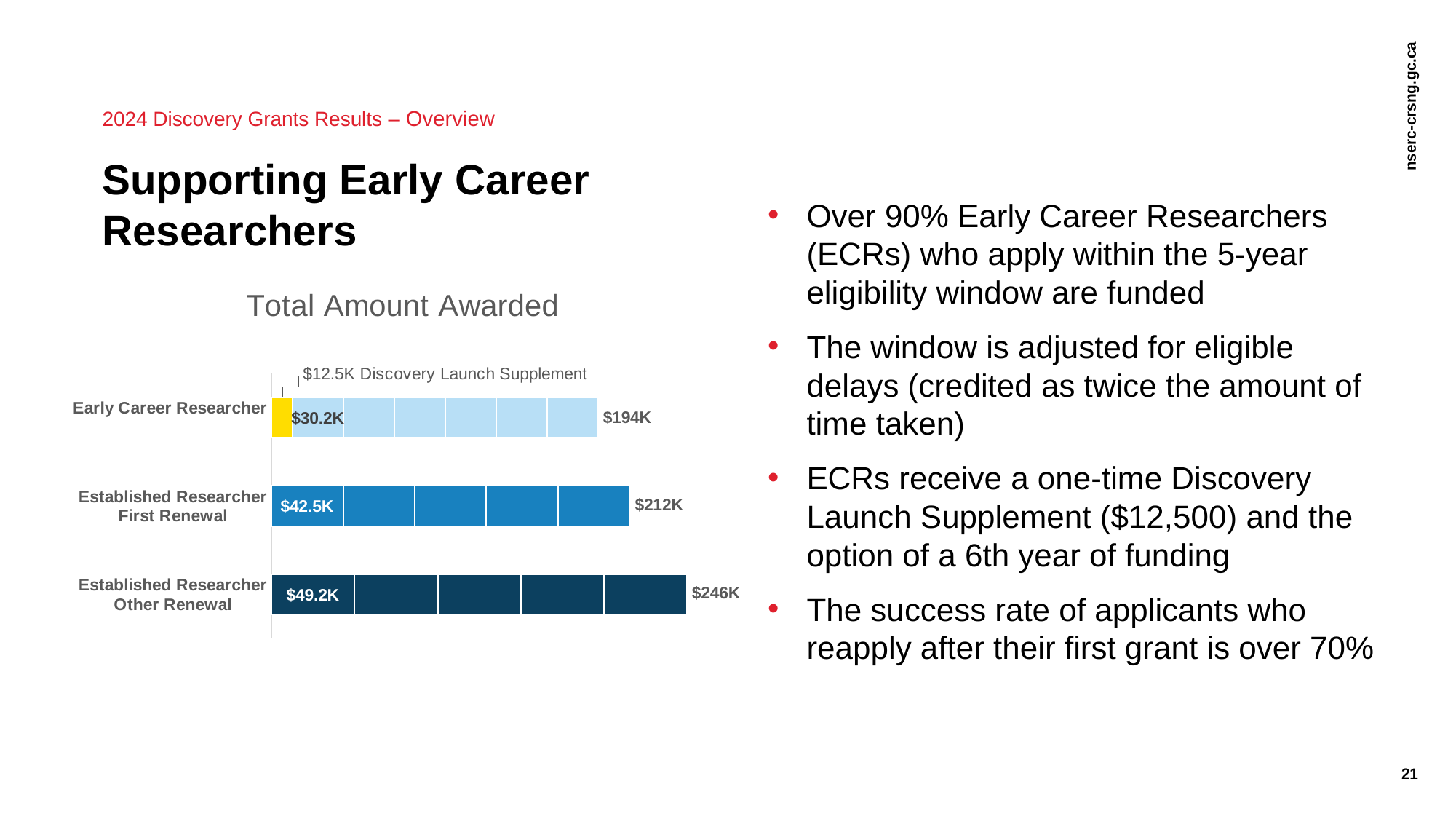
Which category has the highest total amount awarded? Established Researcher Other Renewal What is the total amount awarded shown for Established Researcher First Renewal? $212K What is the annual amount labelled on the first segment of the Early Career Researcher bar? $30.2K What is the annual amount labelled on the first segment of the Established Researcher First Renewal bar? $42.5K Which category has the lowest total amount awarded? Early Career Researcher How many researcher categories are shown in the chart? 3 What is the difference between the total amount awarded for Established Researcher Other Renewal and Established Researcher First Renewal? $34K Which is larger: the annual amount for Established Researcher Other Renewal ($49.2K) or for Established Researcher First Renewal ($42.5K)? Established Researcher Other Renewal What is the total amount awarded shown for Early Career Researcher? $194K What is the total amount awarded shown for Established Researcher Other Renewal? $246K What is the difference between the total amount awarded for Established Researcher First Renewal and Early Career Researcher? $18K What type of chart is used to show Total Amount Awarded? Bar chart